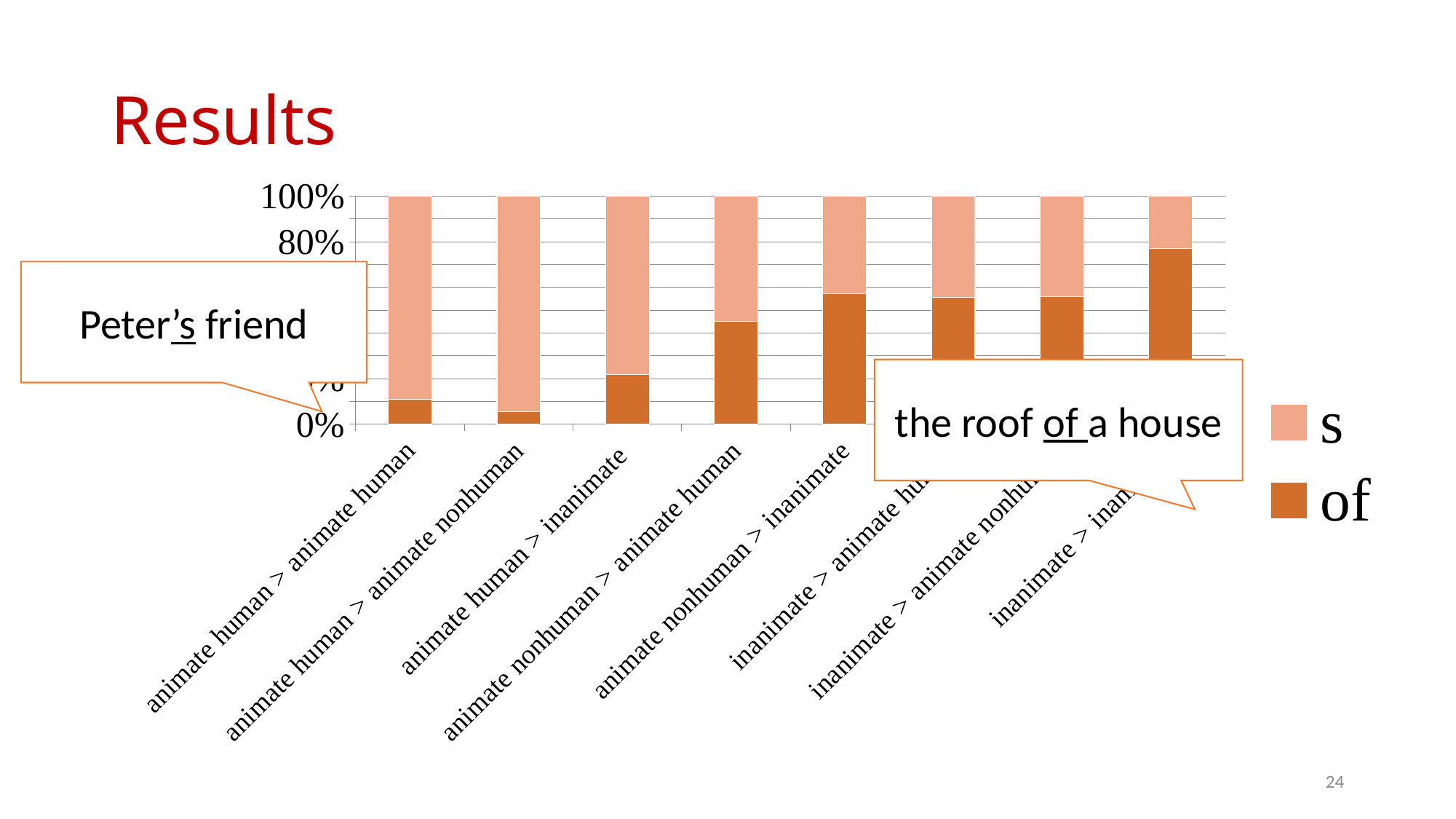
What does each stacked bar total? 100% Which category has the largest share for the 's' series? animate human > animate nonhuman Does the 'of' share generally rise or fall moving from left to right across the categories? rise What kind of chart is shown on the slide? stacked bar chart How many bars (categories) does the chart show? 8 Which category has the smallest share for the 'of' series? animate human > animate nonhuman What is the title of the slide containing the chart? Results Is the 'of' share for 'animate human > inanimate' larger or smaller than for 'animate nonhuman > animate human'? smaller Which bar has the largest share for the 'of' series? the rightmost bar How many series does the legend list? 2 What are the two series named in the legend? s and of Is the 'of' share for 'animate human > animate human' greater or less than 80%? less